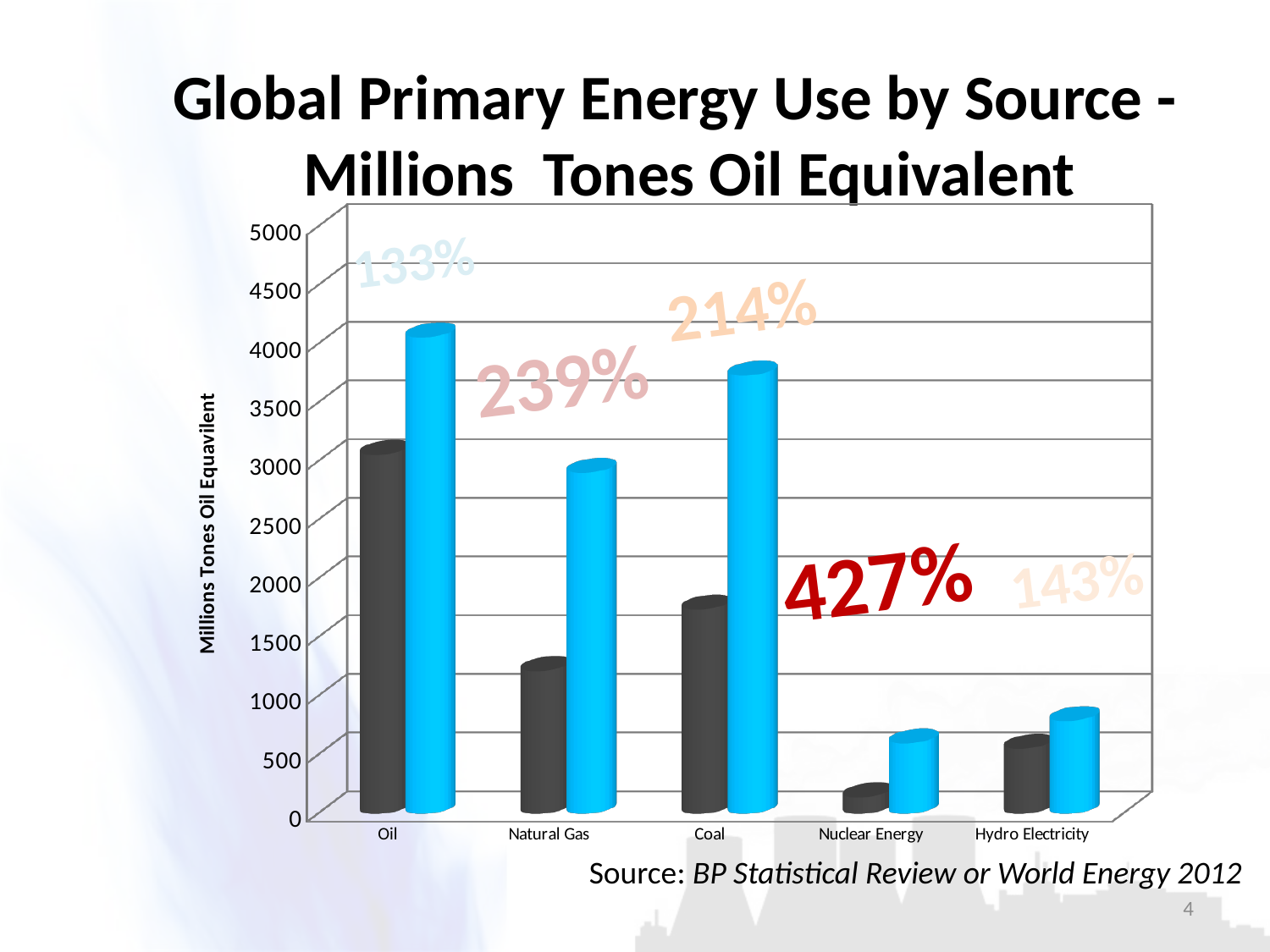
Which has the larger blue bar, Coal or Natural Gas? Coal Which energy source has the tallest bar on the chart? Oil Which energy source has the shortest bars on the chart? Nuclear Energy Is the value of the blue bar for Natural Gas greater or less than 3500? less What kind of chart is shown on the slide? bar chart Is the value of the blue bar for Coal greater or less than 3000? greater Is the value of the blue bar for Oil greater or less than 3500? greater What is the label on the vertical axis of the chart? Millions Tones Oil Equavilent How many energy source categories are shown on the x axis? 5 Which percentage label is shown above the Nuclear Energy bars? 427%